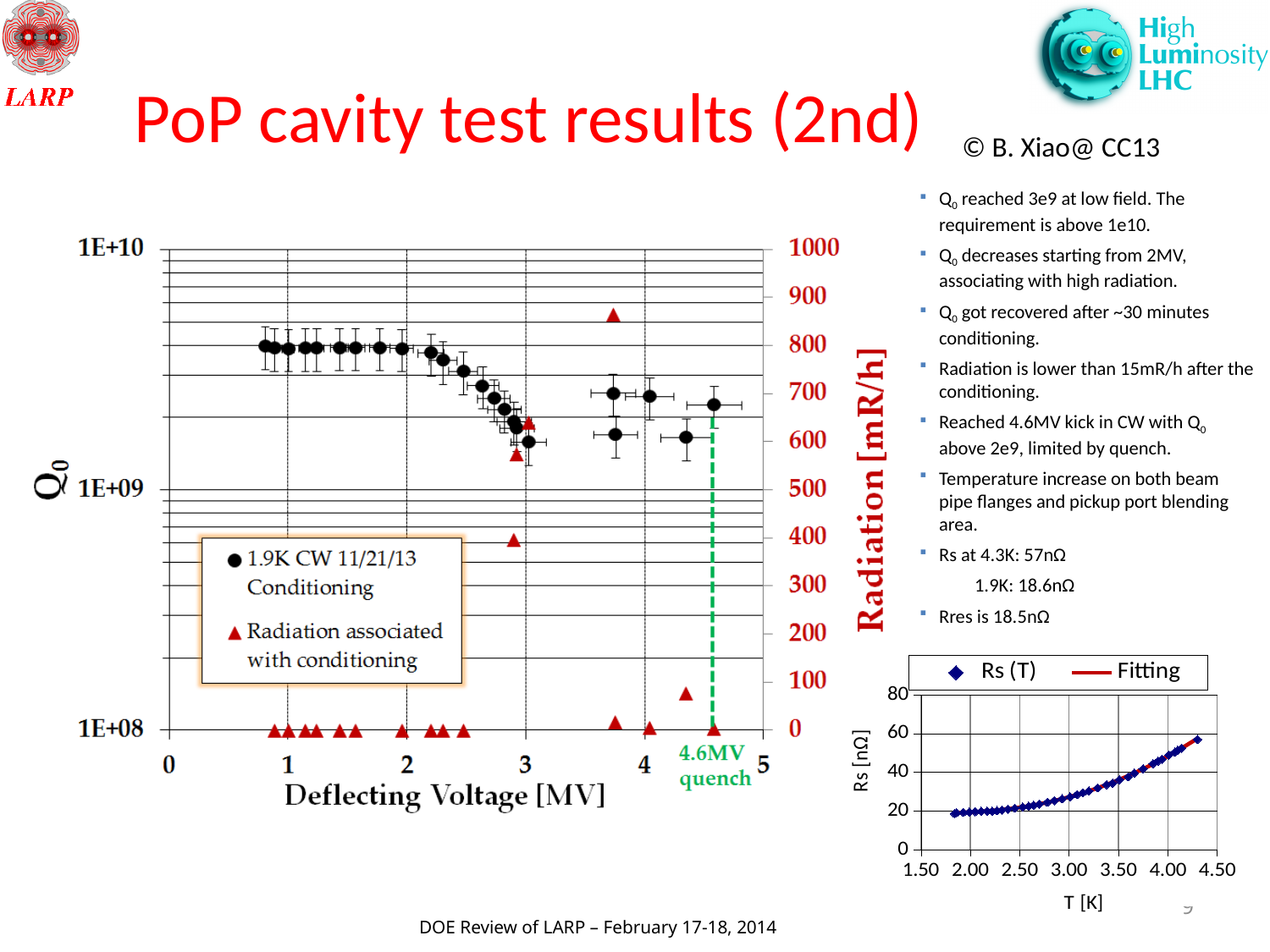
What kind of chart is the small Rs versus T chart at the bottom right? scatter chart with a fitted line How many series does the legend of the small Rs versus T chart at the bottom right list? 2 In the main chart on the left, is the Q0 value at about 1 MV greater or less than 1E+09? greater In the main chart on the left, is the highest radiation point (near 3.75 MV) greater or less than 800 mR/h? greater In the main chart on the left, at what deflecting voltage does the annotated quench occur? 4.6MV In the small Rs versus T chart, is the Rs value at T = 2.00 K greater or less than 40 nΩ? less In the main chart on the left, is the Q0 value larger at about 1 MV or at about 3 MV? about 1 MV In the main chart on the left, what is the label of the x axis? Deflecting Voltage [MV] In the small Rs versus T chart, do the Rs values rise or fall as T increases? rise In the main chart on the left, what is the label of the right-hand y axis? Radiation [mR/h] How many series does the legend of the main chart on the left list? 2